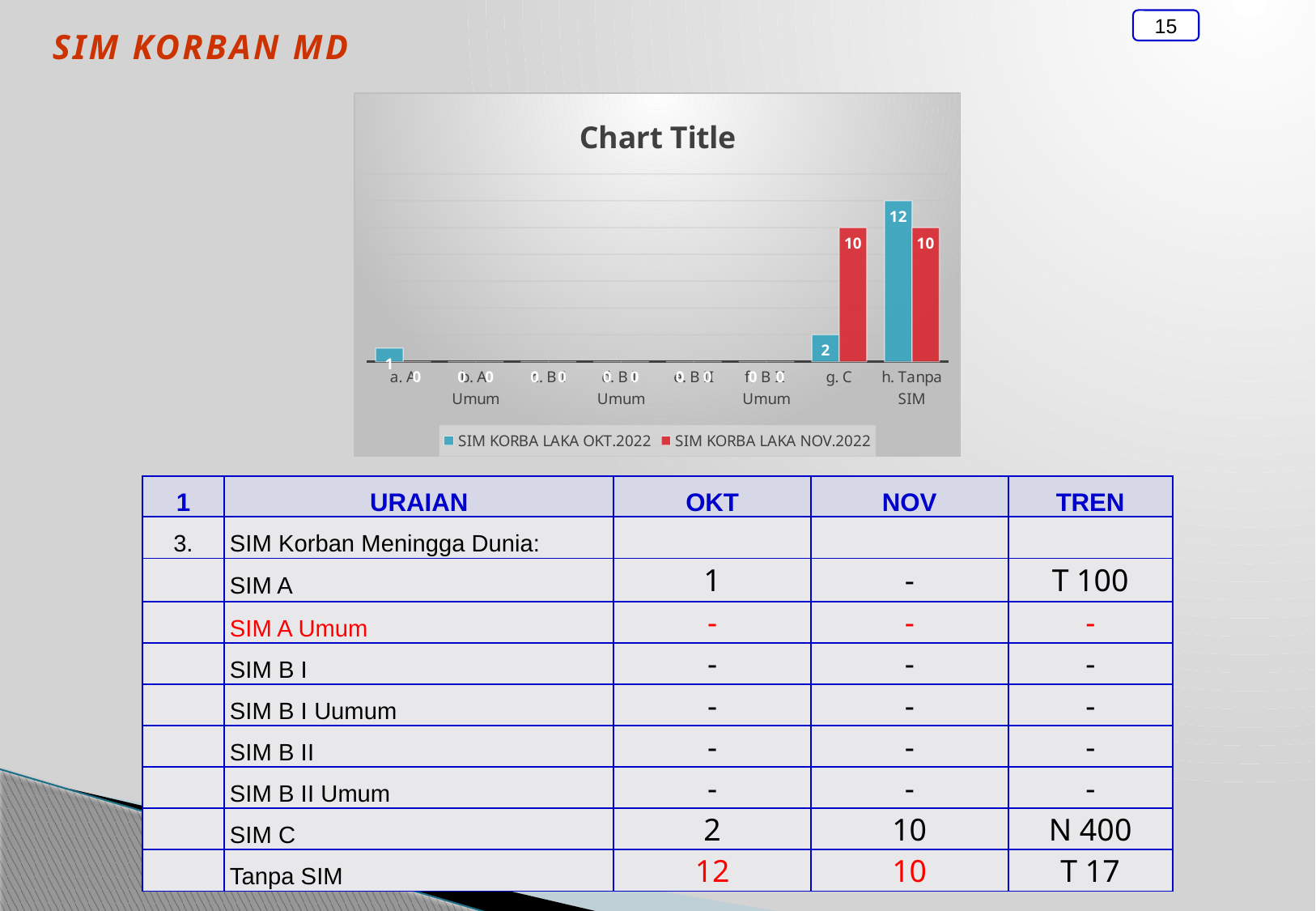
For g. C, which series has the larger value, SIM KORBA LAKA OKT.2022 or SIM KORBA LAKA NOV.2022? SIM KORBA LAKA NOV.2022 What is the value for g. C in the SIM KORBA LAKA NOV.2022 series? 10 What is the value for g. C in the SIM KORBA LAKA OKT.2022 series? 2 What is the value for h. Tanpa SIM in the SIM KORBA LAKA NOV.2022 series? 10 What kind of chart is shown on the slide? bar chart What is the value for h. Tanpa SIM in the SIM KORBA LAKA OKT.2022 series? 12 What is the value for a. A in the SIM KORBA LAKA OKT.2022 series? 1 How many series does the chart legend list? 2 Which category has the highest value in the SIM KORBA LAKA OKT.2022 series? h. Tanpa SIM What is the difference between the SIM KORBA LAKA NOV.2022 and SIM KORBA LAKA OKT.2022 values for g. C? 8 What is the title shown on the chart? Chart Title What is the difference between the SIM KORBA LAKA OKT.2022 and SIM KORBA LAKA NOV.2022 values for h. Tanpa SIM? 2